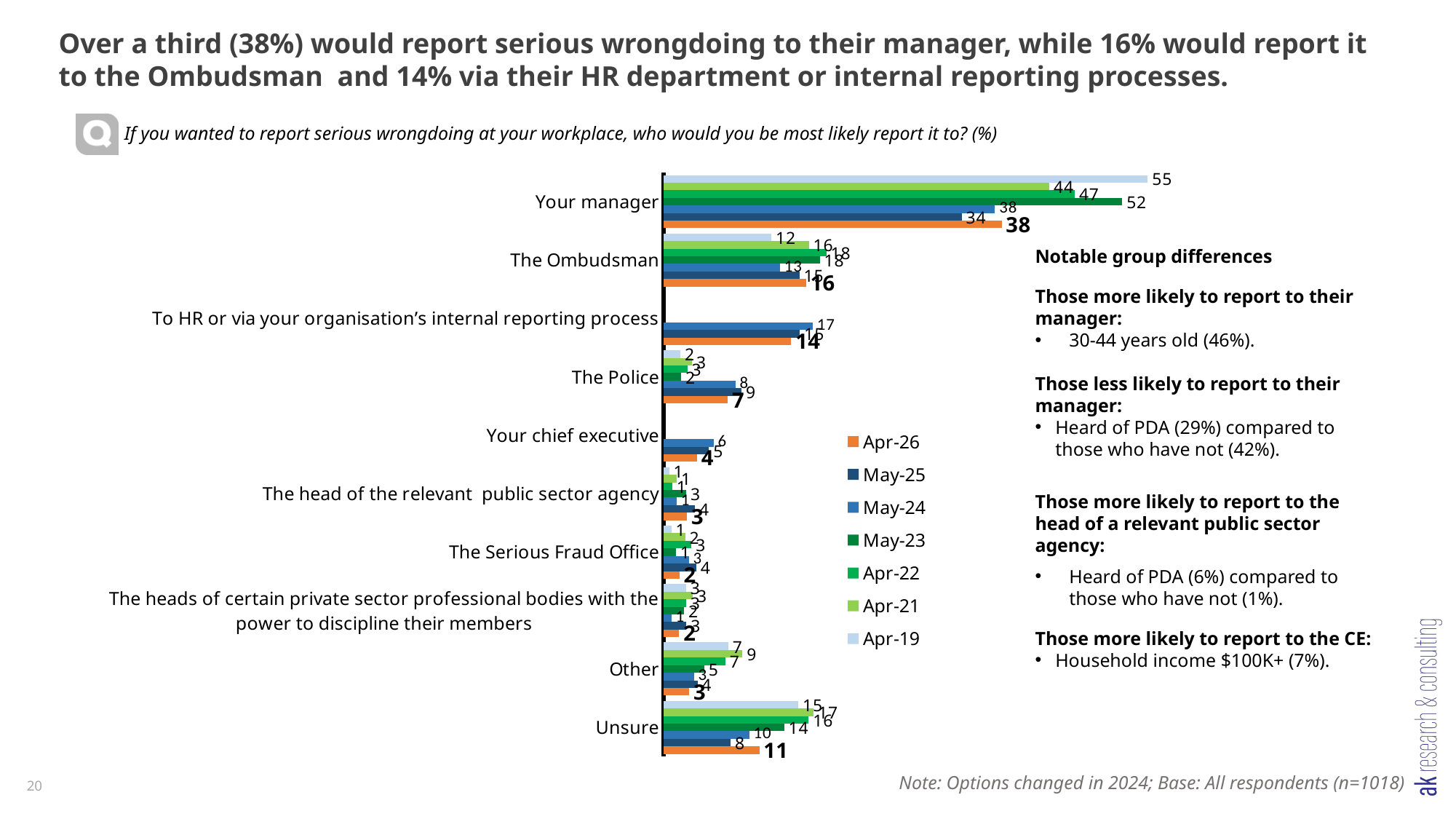
What kind of chart is shown on the slide? Bar chart How many categories are shown on the chart? 10 Which category has the highest Apr-26 value? Your manager What is the difference between the Apr-19 and Apr-26 values for 'Your manager'? 17 What is the May-25 value for 'Your manager'? 34 What is the Apr-26 value for 'Unsure'? 11 Which series is listed first in the legend? Apr-26 Which is larger for 'The Ombudsman': the Apr-22 value or the Apr-19 value? Apr-22 What is the Apr-26 value for 'Your manager'? 38 What is the difference between the May-24 and Apr-26 values for 'To HR or via your organisation's internal reporting process'? 3 What is the Apr-19 value for 'Your manager'? 55 How many series does the legend list? 7